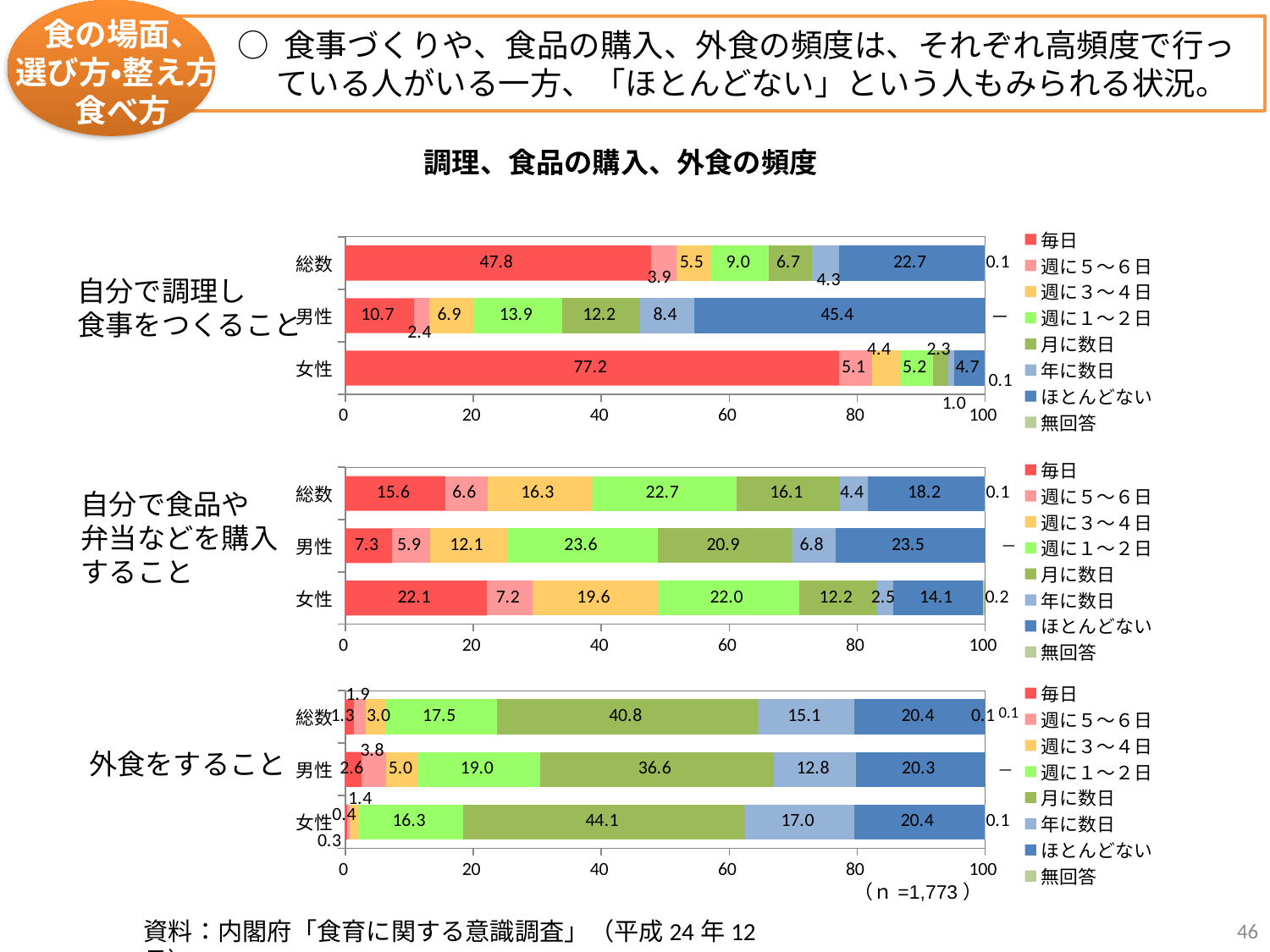
In the middle chart (自分で食品や弁当などを購入すること), which category has the lowest 毎日 value? 男性 In the bottom chart (外食をすること), is the 月に数日 value for 総数 greater or less than 40? greater In the top chart (自分で調理し食事をつくること), which category has the highest 毎日 value? 女性 In the top chart (自分で調理し食事をつくること), what is the difference between the 毎日 values for 女性 and 男性? 66.5 In the bottom chart (外食をすること), what is the value for 月に数日 for 女性? 44.1 In the middle chart (自分で食品や弁当などを購入すること), what is the value for 週に1〜2日 for 総数? 22.7 What is the title shown above the three charts? 調理、食品の購入、外食の頻度 What type of chart is used for 外食をすること? Stacked bar chart In the top chart (自分で調理し食事をつくること), what is the value for 毎日 for 女性? 77.2 How many series does the legend of the top chart list? 8 In the middle chart (自分で食品や弁当などを購入すること), which is larger: ほとんどない for 男性 or for 女性? 男性 In the top chart (自分で調理し食事をつくること), what is the value for ほとんどない for 男性? 45.4